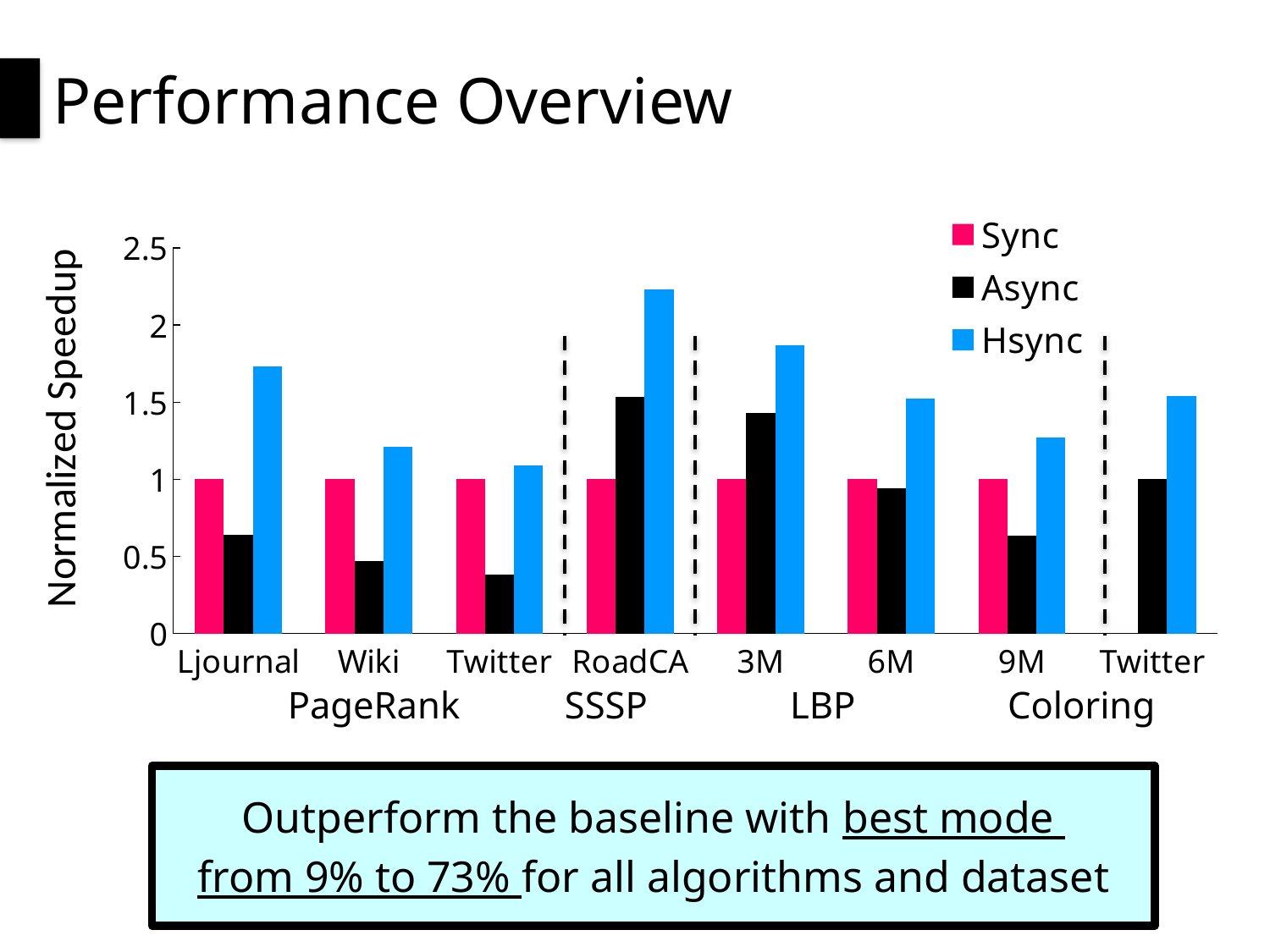
Is the Hsync value for RoadCA greater or less than 2? greater Which category has the highest Hsync value? RoadCA What is the Async value for Twitter under Coloring? 1 What is the Sync value for Ljournal? 1 Which is larger, the Hsync value for Ljournal or for Wiki? Ljournal How many series does the legend list? 3 What kind of chart is shown on the slide? bar chart Which category has the lowest Async value? Twitter under PageRank How many dataset categories are shown along the x axis? 8 Is the Async value for Twitter under PageRank greater or less than 0.5? less Is the Hsync value for 3M greater or less than 1.5? greater What is the label of the y axis? Normalized Speedup